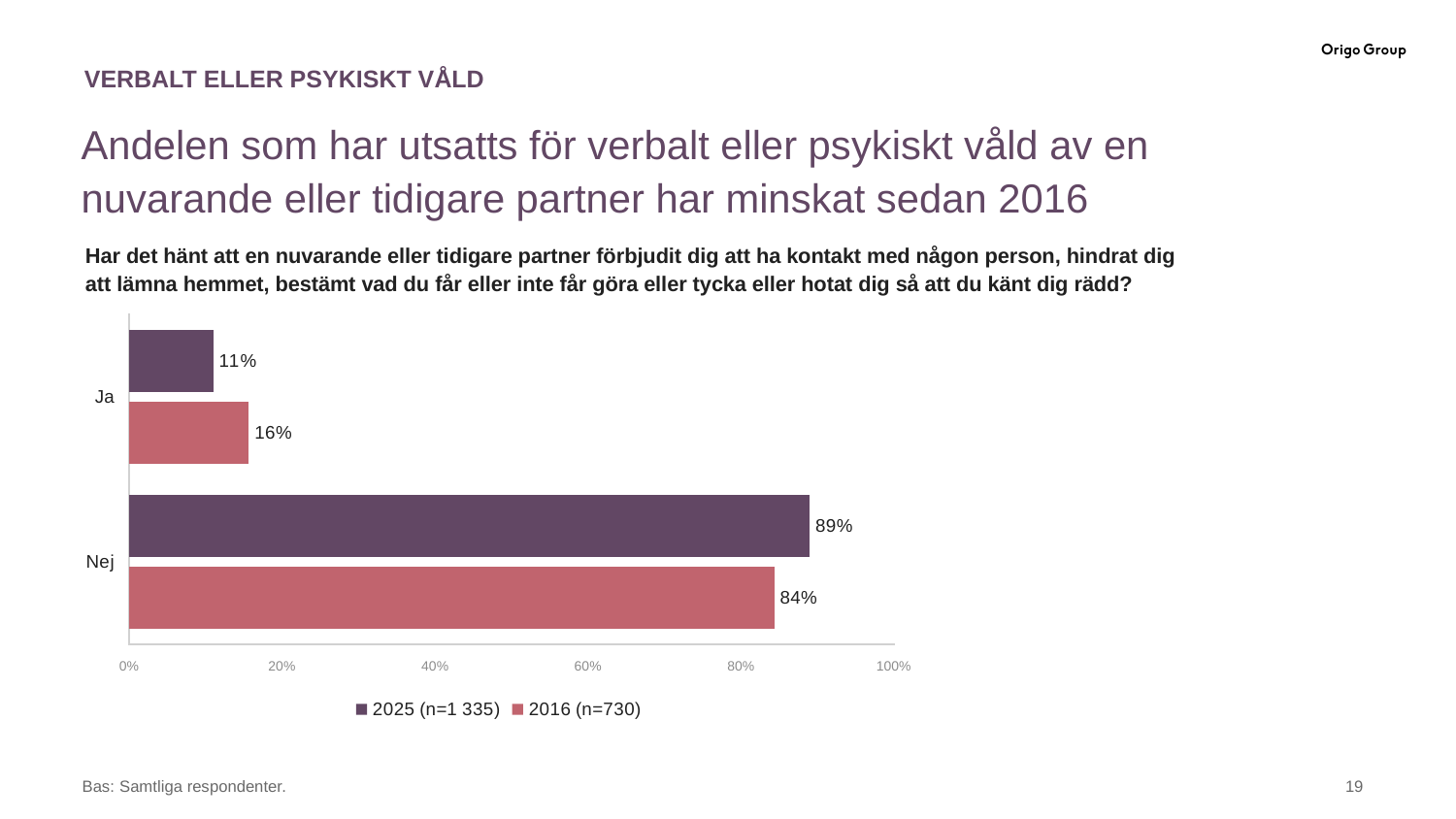
What is the difference between the 2016 and 2025 values for "Ja"? 5 percentage points What is the value for "Nej" in the 2025 (n=1 335) series? 89% What kind of chart is shown on the slide? Bar chart Which series has the larger value for "Ja", 2025 (n=1 335) or 2016 (n=730)? 2016 (n=730) How many categories are shown on the chart? 2 What is the value for "Ja" in the 2025 (n=1 335) series? 11% How many series does the legend list? 2 Which series has the larger value for "Nej", 2025 (n=1 335) or 2016 (n=730)? 2025 (n=1 335) Is the 2016 value for "Nej" greater or less than 80%? greater What is the value for "Ja" in the 2016 (n=730) series? 16% What is the value for "Nej" in the 2016 (n=730) series? 84% What is the difference between the 2025 and 2016 values for "Nej"? 5 percentage points